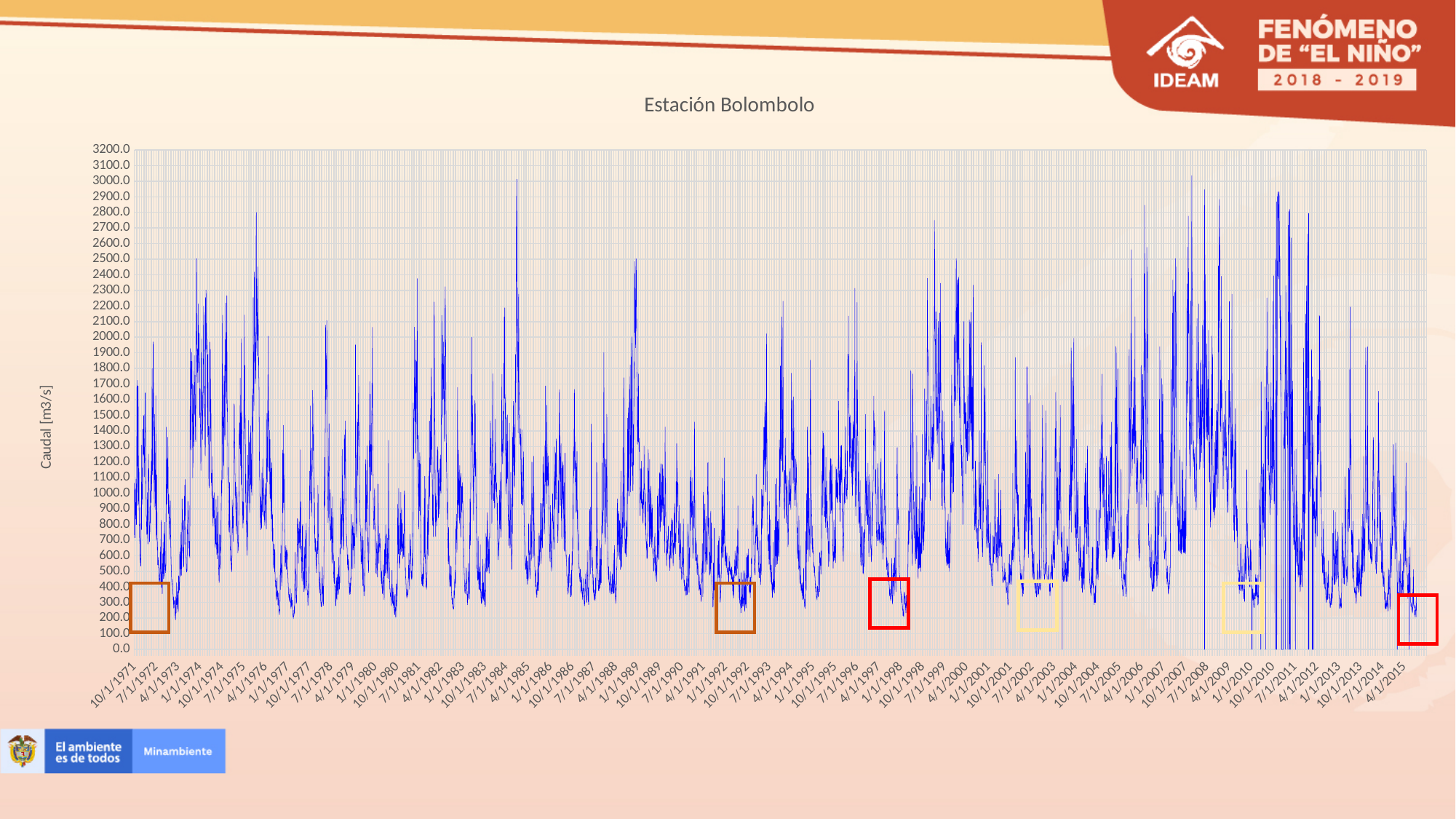
What kind of chart is shown on the slide? line chart Is the peak value near 4/1/1985 greater or less than 2500? greater Is the peak value near 1/1/1976 greater or less than 2000? greater What is the first date label on the horizontal axis? 10/1/1971 Does the plotted series ever exceed 3200 m3/s? No What is the lowest tick value shown on the vertical axis? 0.0 What is the title of the chart? Estación Bolombolo What is the spacing between consecutive tick values on the vertical axis? 100.0 How many highlighted rectangular boxes are drawn over the low-flow periods on the chart? 6 What is the label of the vertical axis? Caudal [m3/s] What is the last date label on the horizontal axis? 4/1/2015 What is the highest tick value shown on the vertical axis? 3200.0